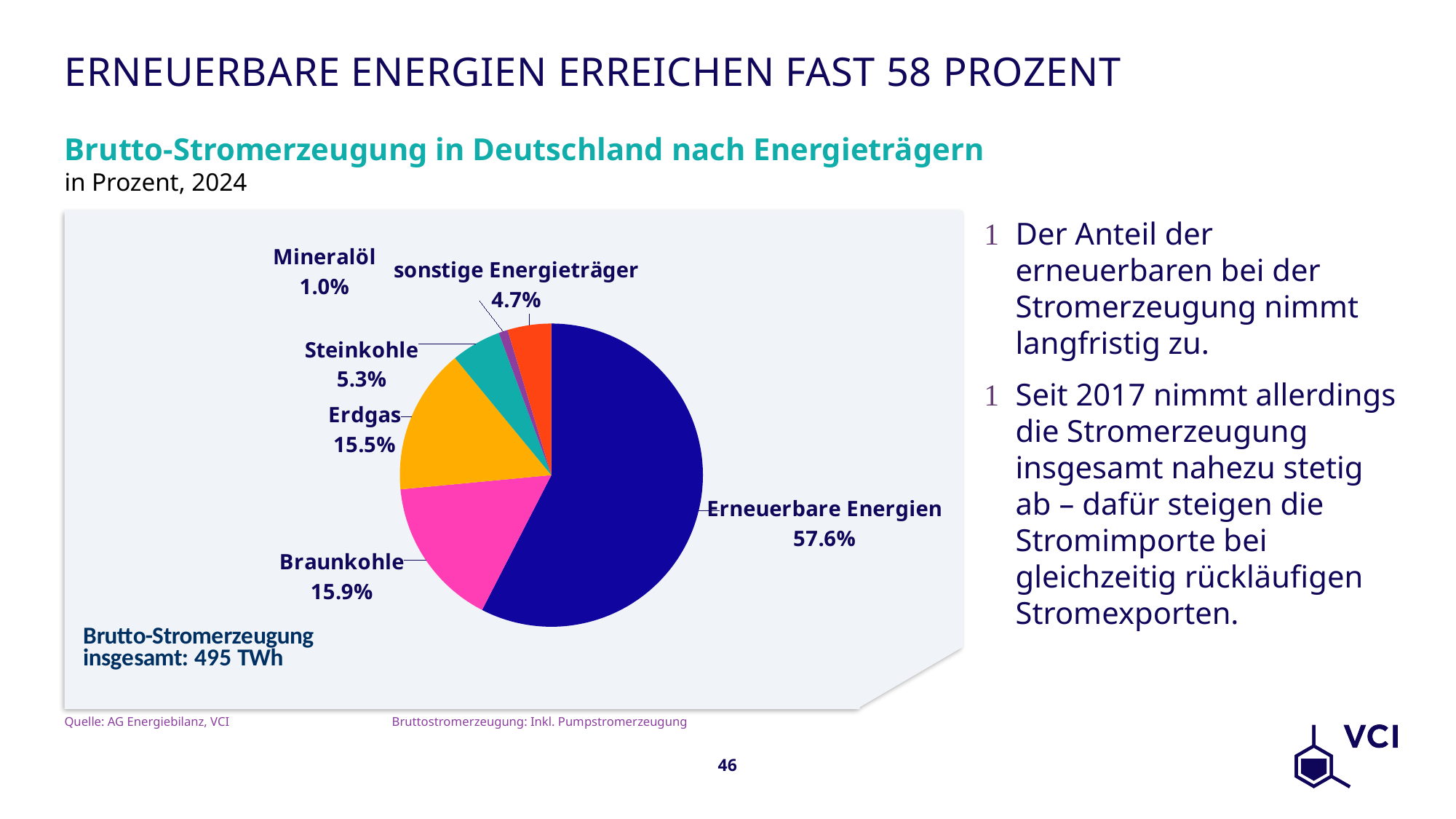
Which energy source has the largest slice of the pie? Erneuerbare Energien Which has a larger share, Steinkohle or sonstige Energieträger? Steinkohle What is the difference in percentage points between Braunkohle and Erdgas? 0.4 What is the share shown for Steinkohle? 5.3% Which energy source has the smallest slice of the pie? Mineralöl What is the share shown for sonstige Energieträger? 4.7% What is the share shown for Braunkohle? 15.9% What is the share shown for Erdgas? 15.5% What share of gross electricity generation does Erneuerbare Energien have in the pie chart? 57.6% How many energy source categories are shown in the pie chart? 6 What type of chart is shown on the slide? Pie chart What total gross electricity generation in TWh is stated on the chart? 495 TWh